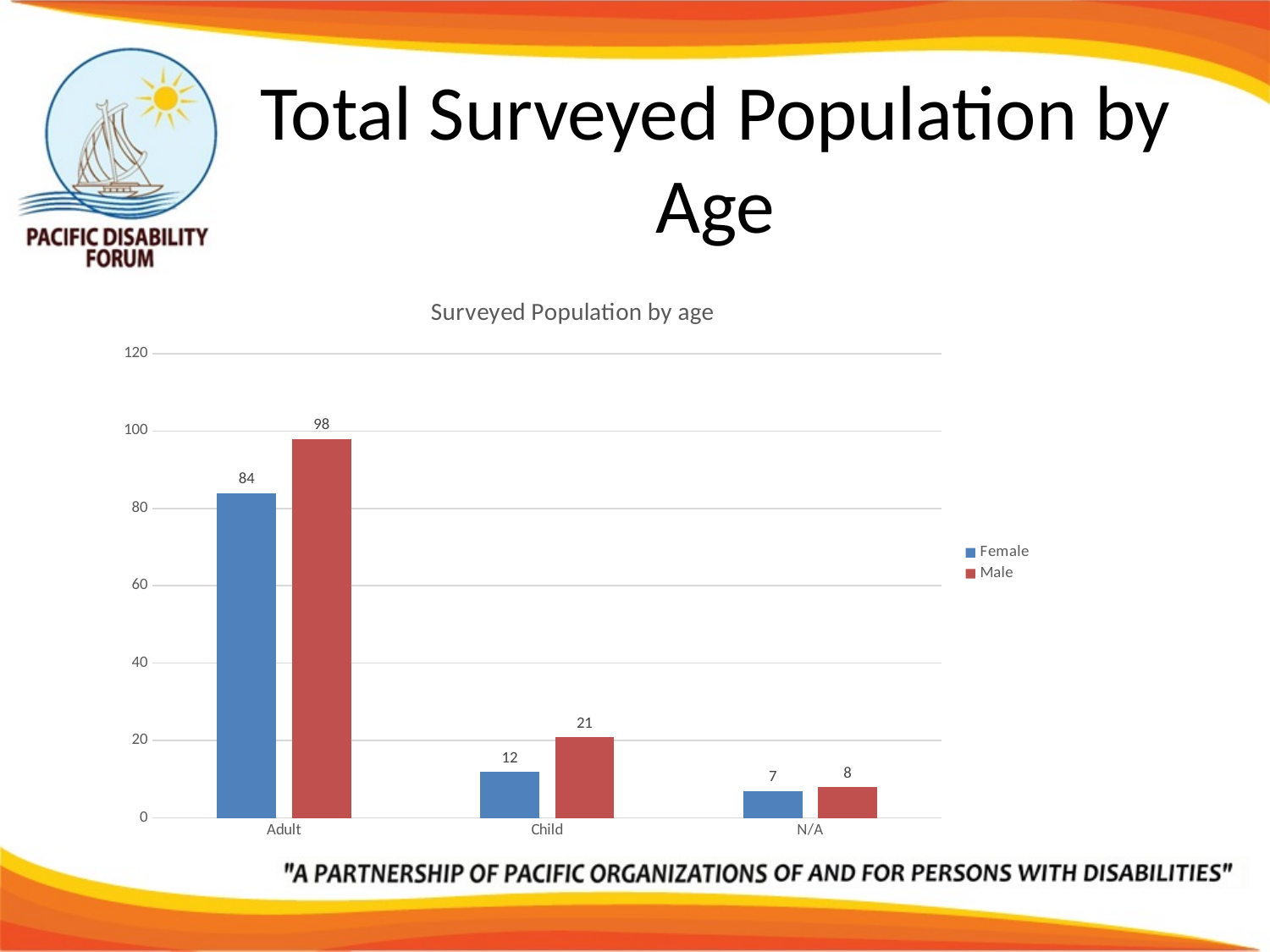
How many series does the legend list? 2 Which is larger for Child, the Female value or the Male value? Male What is the title of the chart? Surveyed Population by age What is the Female value for Adult? 84 What is the Male value for Child? 21 How many categories are shown on the x axis? 3 What kind of chart is shown? Bar chart Which category has the lowest Female value? N/A What is the Female value for N/A? 7 What is the difference between the Male and Female values for Adult? 14 Is the Male value for Adult greater or less than 80? greater Which category has the highest Male value? Adult